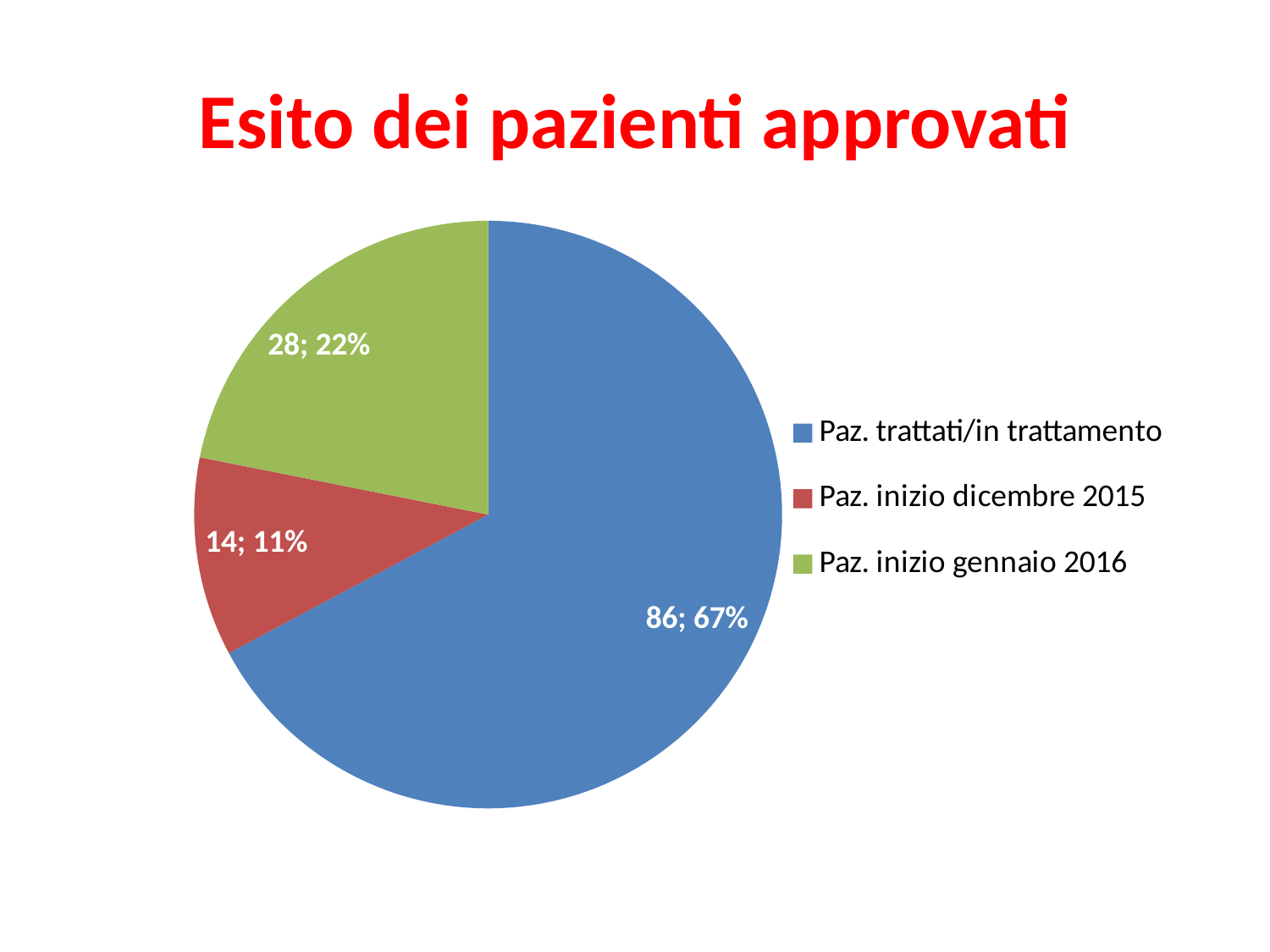
What is the title of the chart? Esito dei pazienti approvati How many slices does the pie chart have? 3 Which category has the smallest slice? Paz. inizio dicembre 2015 What is the value for Paz. trattati/in trattamento? 86 What is the difference between the values for Paz. inizio gennaio 2016 and Paz. inizio dicembre 2015? 14 Which category has the largest slice? Paz. trattati/in trattamento What share of the pie does Paz. trattati/in trattamento represent? 67% What is the value for Paz. inizio gennaio 2016? 28 What is the value for Paz. inizio dicembre 2015? 14 What kind of chart is shown on the slide? pie chart What share of the pie does Paz. inizio gennaio 2016 represent? 22% Which is larger, the value for Paz. inizio gennaio 2016 or Paz. inizio dicembre 2015? Paz. inizio gennaio 2016